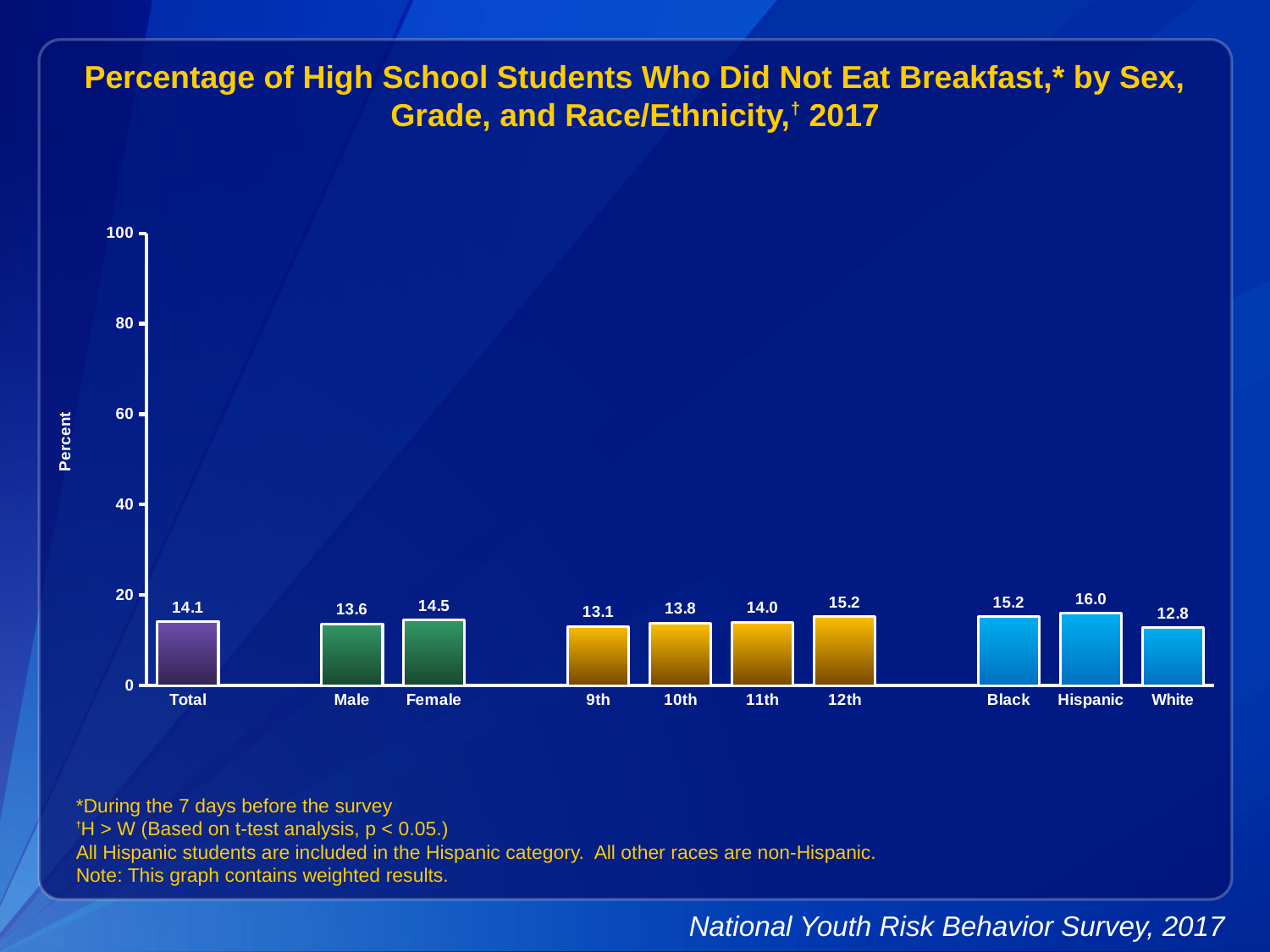
What percentage of Female students did not eat breakfast? 14.5 Is the value for 12th grade greater or less than 20? less What is the difference between the Female and Male values? 0.9 What is the value for Hispanic students? 16.0 Which is larger, the value for Black or the value for White? Black Do the values rise or fall from 9th grade to 12th grade? rise What is the value for Total? 14.1 What kind of chart is this? bar chart Which category has the lowest value? White How many categories are shown on the x axis? 10 Which category has the highest value? Hispanic What is the value for 9th grade students? 13.1